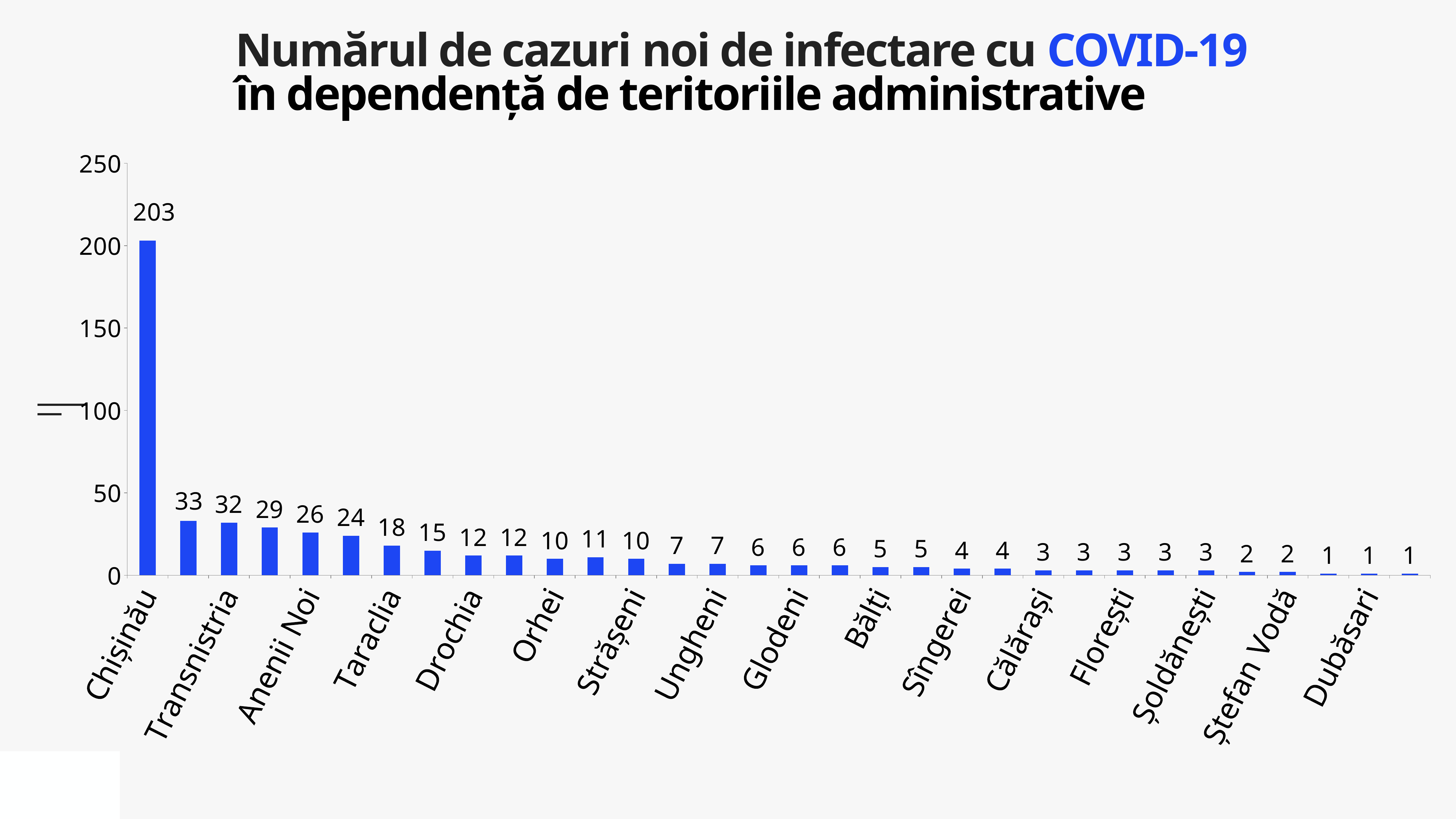
What is the difference between the number of new cases in Chișinău and in Dubăsari? 202 How many new cases are shown for Ștefan Vodă? 2 What type of chart is shown on the slide? bar chart How many new cases are shown for Dubăsari? 1 Which territory has the highest number of new COVID-19 cases? Chișinău How many new COVID-19 cases are shown for Chișinău? 203 How many new cases are shown for Glodeni? 6 How many new cases are shown for Ungheni? 7 Which has more new cases, Chișinău or Transnistria? Chișinău How many new cases are shown for Florești? 3 Is the value for Chișinău greater or less than 200? greater Is the value for Transnistria greater or less than 50? less